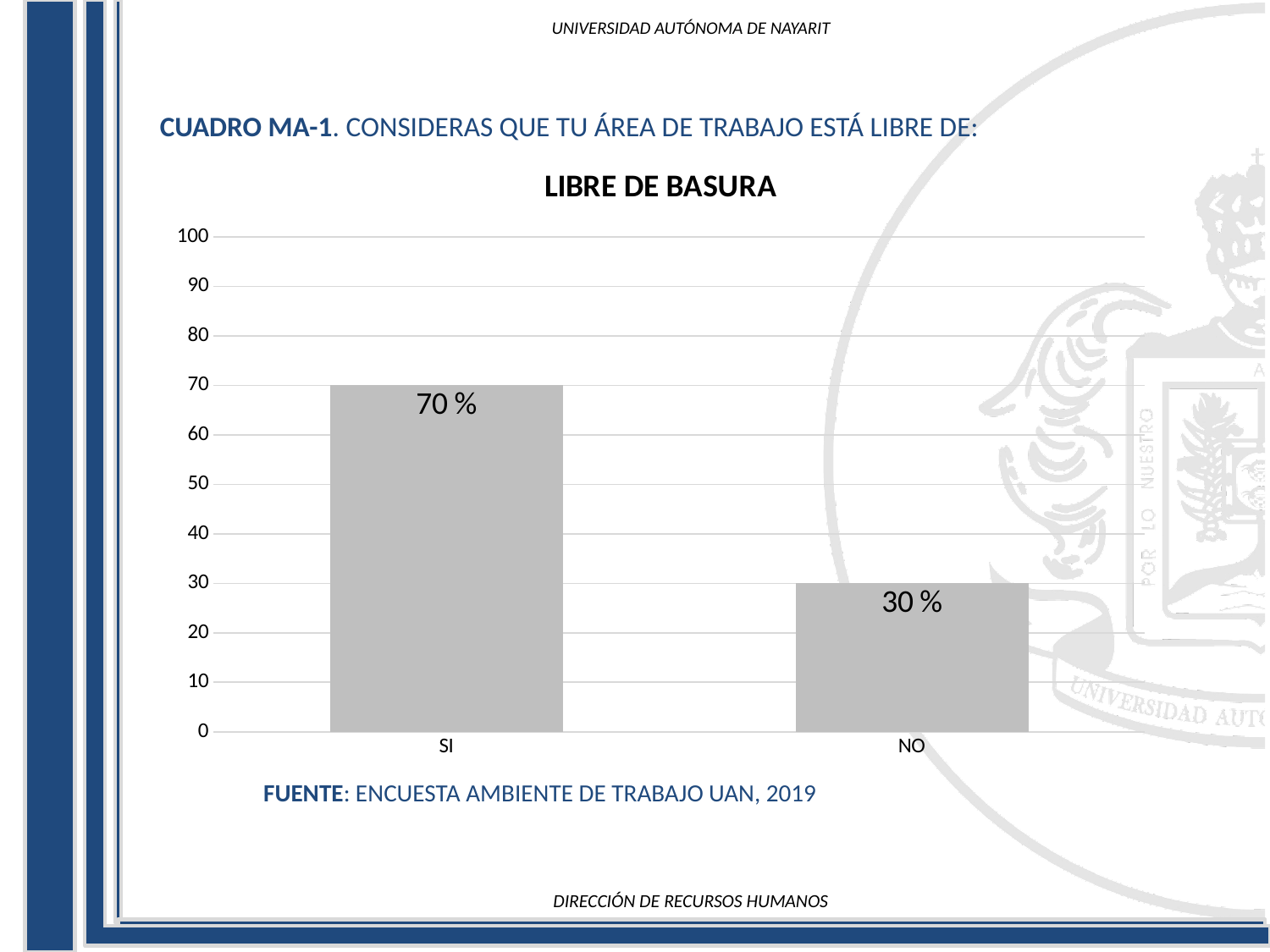
Which category has the highest value? SI What is the difference between the values for SI and NO? 40 % What is the value for SI? 70 % Is the value for SI greater or less than 60? greater Which category has the lowest value? NO What is the title of the chart? LIBRE DE BASURA Is the value for NO greater or less than 50? less How many categories are shown on the x axis? 2 What is the value for NO? 30 % Which is larger, the value for SI or the value for NO? SI What is the highest value shown on the y axis? 100 What kind of chart is shown? bar chart